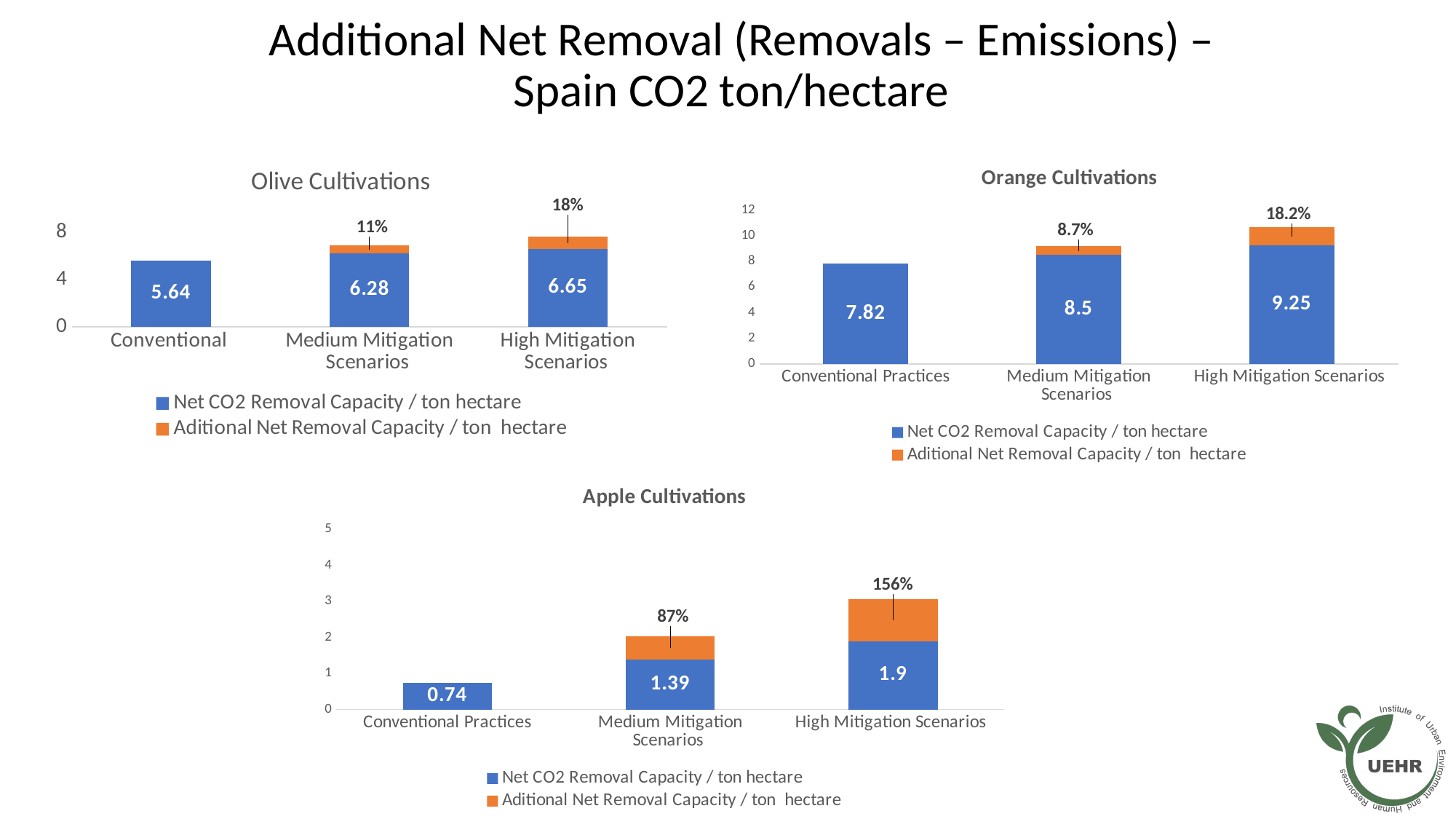
How many series does the legend of the Apple Cultivations chart list? 2 In the Apple Cultivations chart, which category has the lowest Net CO2 Removal Capacity? Conventional Practices In the Olive Cultivations chart, what is the Net CO2 Removal Capacity for Conventional? 5.64 In the Orange Cultivations chart, which category has the highest Net CO2 Removal Capacity? High Mitigation Scenarios In the Apple Cultivations chart, what percentage label is shown above the High Mitigation Scenarios bar? 156% What kind of chart is the Orange Cultivations chart? Stacked bar chart In the Orange Cultivations chart, is the Net CO2 Removal Capacity for Medium Mitigation Scenarios greater or less than 8? greater In the Olive Cultivations chart, what percentage label is shown above the High Mitigation Scenarios bar? 18% In the Apple Cultivations chart, what is the Net CO2 Removal Capacity for Conventional Practices? 0.74 In the Olive Cultivations chart, what is the difference in Net CO2 Removal Capacity between High Mitigation Scenarios and Conventional? 1.01 In the Orange Cultivations chart, what percentage label is shown above the Medium Mitigation Scenarios bar? 8.7% In the Orange Cultivations chart, what is the Net CO2 Removal Capacity for High Mitigation Scenarios? 9.25